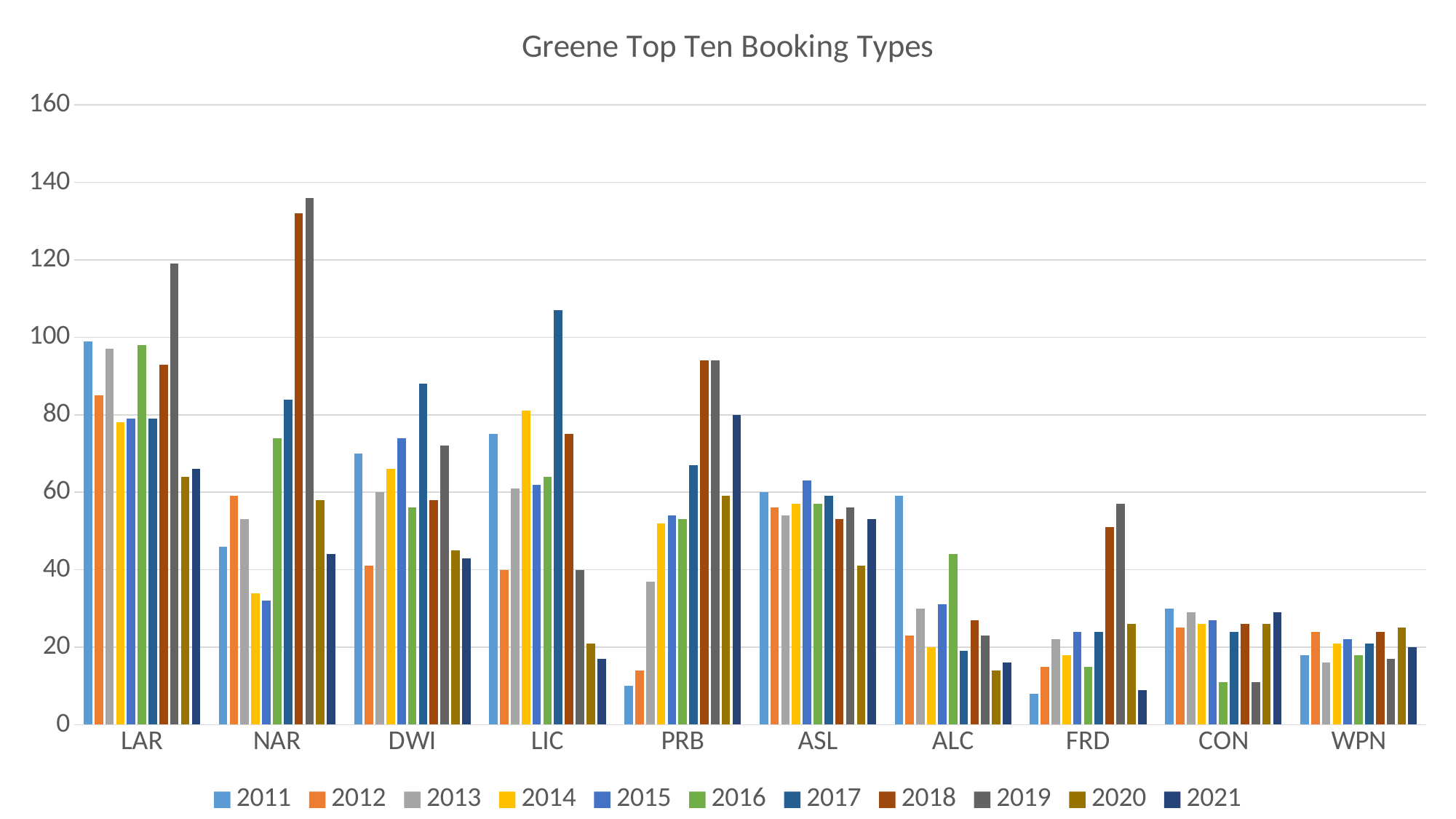
How many series does the legend list? 11 What is the title of the chart? Greene Top Ten Booking Types Is the value for LIC in 2021 greater or less than 20? less How many booking type categories are shown on the x axis? 10 Which year has the highest value for LIC? 2017 What kind of chart is shown on the slide? bar chart Which year has the lowest value for PRB? 2011 Is the value for LAR in 2019 greater or less than 100? greater Which is larger, the 2011 value for LAR or the 2011 value for NAR? LAR Which year has the lowest value for FRD? 2011 Is the value for NAR in 2019 greater or less than 120? greater Which year has the highest value for NAR? 2019